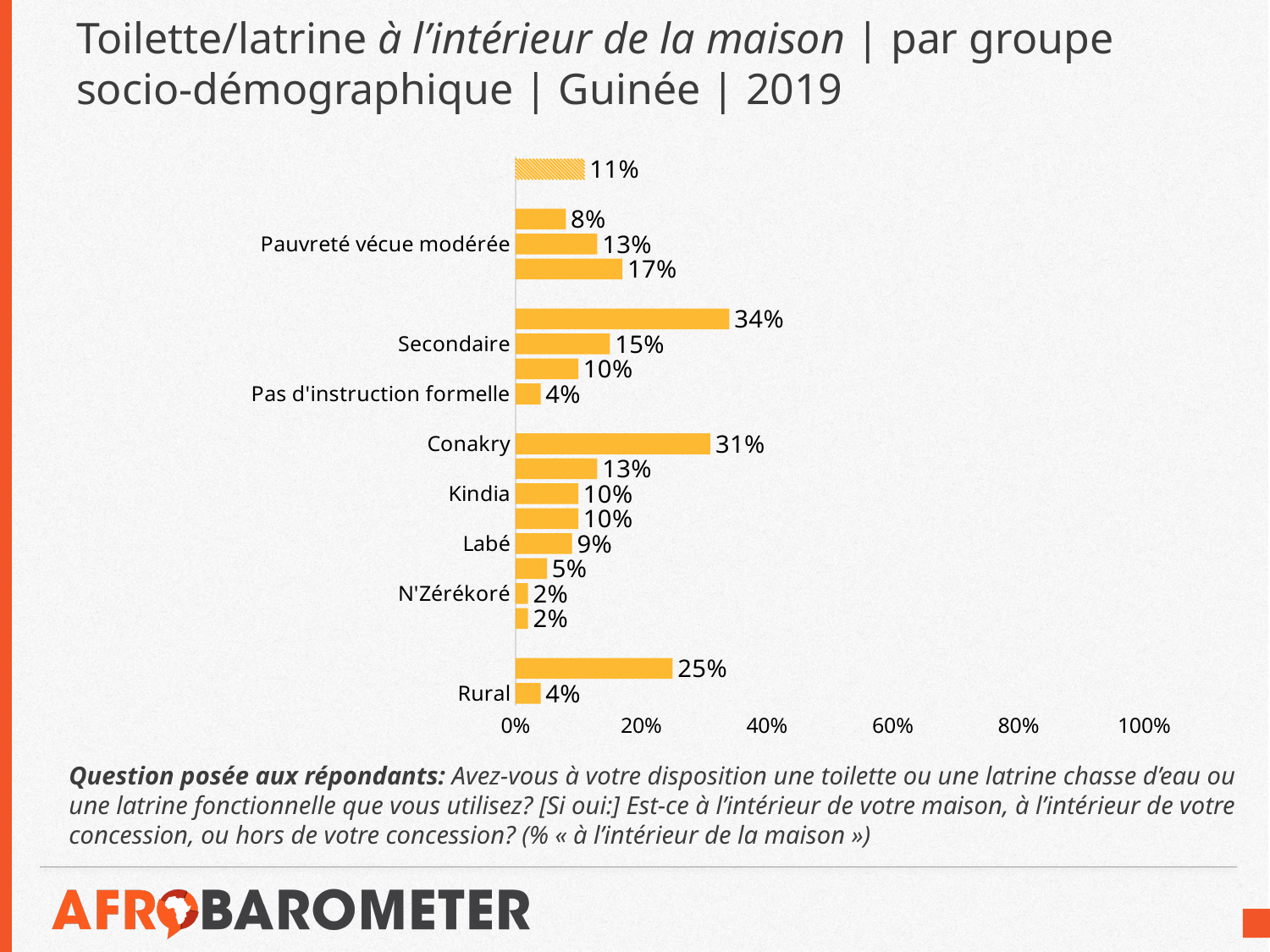
What is the value for Conakry? 31% What type of chart is shown on the slide? bar chart Is the value for Conakry greater or less than 20%? greater What is the value for N'Zérékoré? 2% What is the highest value shown on the chart? 34% What is the value for Rural? 4% Which year does the chart title refer to? 2019 What is the value for Secondaire? 15% What is the difference between the values for Conakry and Kindia? 21% Which is larger, the value for Kindia or the value for Labé? Kindia What is the value for Pas d'instruction formelle? 4% What is the value for Pauvreté vécue modérée? 13%